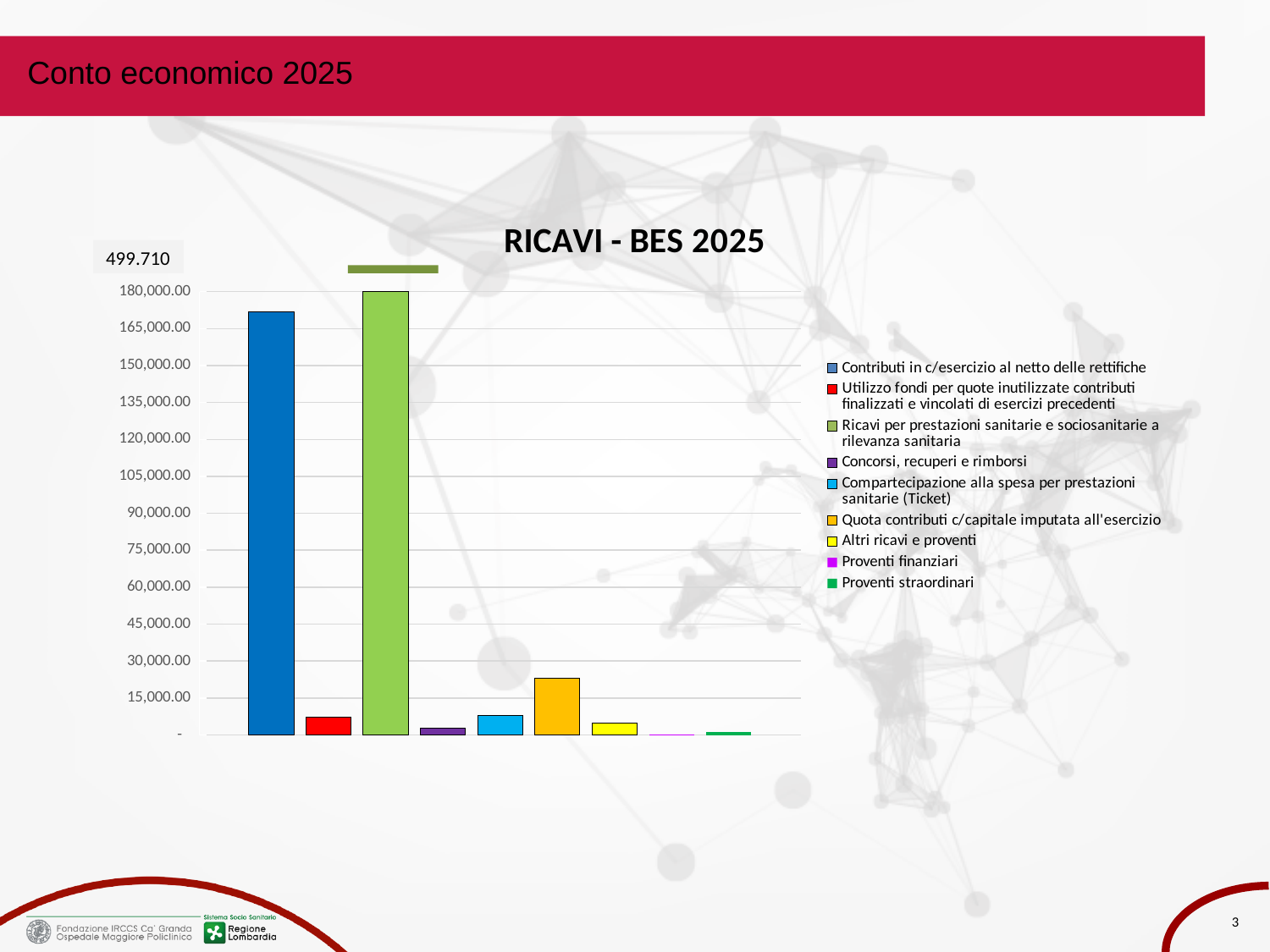
Is the value for Contributi in c/esercizio al netto delle rettifiche greater or less than 165,000.00? greater What is the title of the chart? RICAVI - BES 2025 How many series does the legend list? 9 What is the highest value labelled on the vertical axis? 180,000.00 Is the value for Quota contributi c/capitale imputata all'esercizio greater or less than 30,000.00? less Which is larger: Contributi in c/esercizio al netto delle rettifiche or Concorsi, recuperi e rimborsi? Contributi in c/esercizio al netto delle rettifiche Which series has the tallest bar? Ricavi per prestazioni sanitarie e sociosanitarie a rilevanza sanitaria Which is larger: Quota contributi c/capitale imputata all'esercizio or Compartecipazione alla spesa per prestazioni sanitarie (Ticket)? Quota contributi c/capitale imputata all'esercizio How many bars are plotted in the chart? 9 Is the value for Utilizzo fondi per quote inutilizzate contributi finalizzati e vincolati di esercizi precedenti greater or less than 15,000.00? less What kind of chart is shown on the slide? bar chart What colour is the bar for Contributi in c/esercizio al netto delle rettifiche? blue